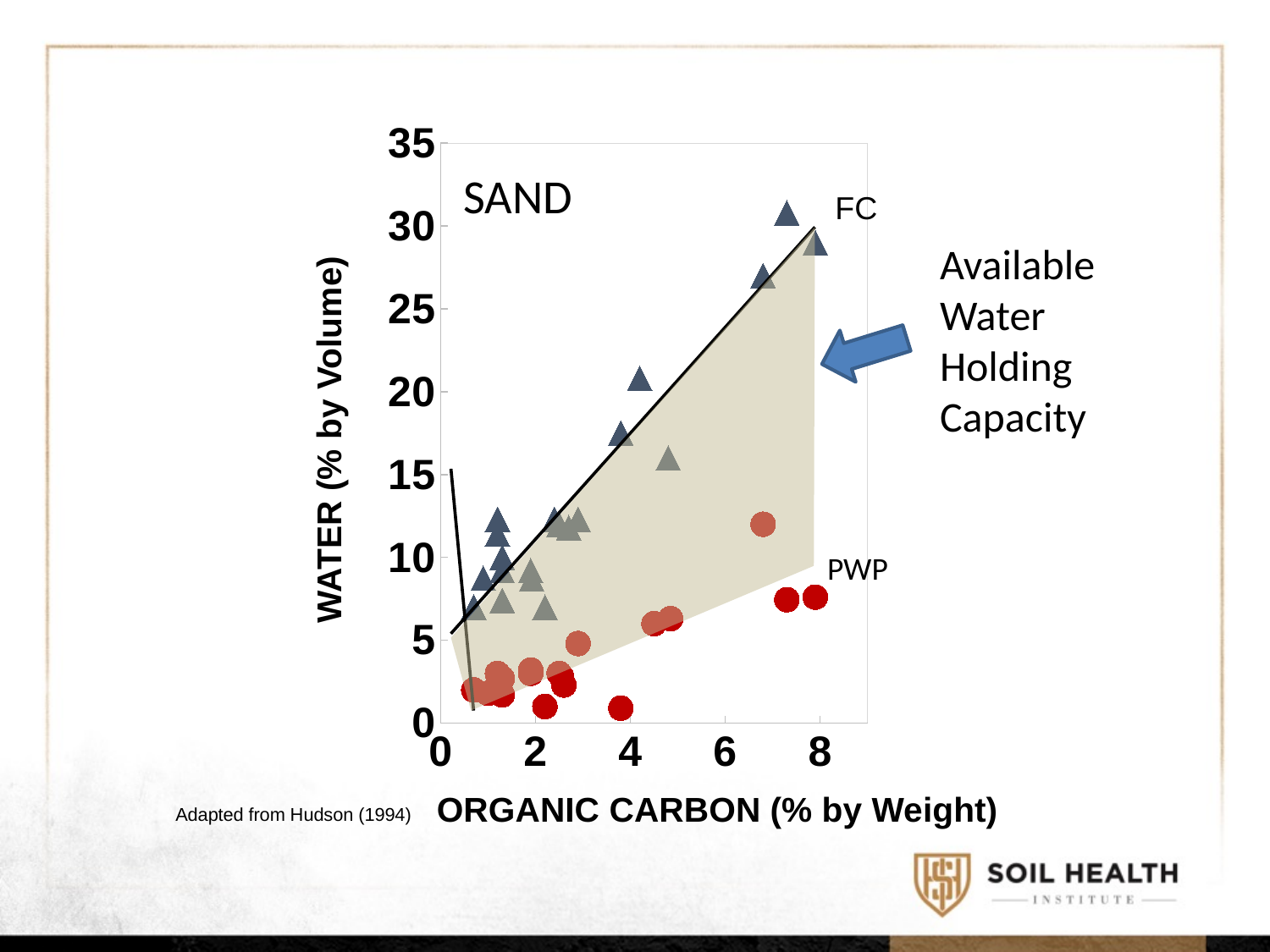
Which series has the higher water values, FC or PWP? FC What is the title of the x axis of the chart? ORGANIC CARBON (% by Weight) What is the title of the y axis of the chart? WATER (% by Volume) Is the lowest FC (triangle) value greater or less than 10? less Is the highest PWP (circle) value greater or less than 15? less What is the maximum tick value shown on the x axis of the chart? 8 How many data series are plotted on the chart? 2 Do the FC (triangle) values rise or fall as organic carbon increases along the x axis? rise Do the PWP (circle) values generally rise or fall as organic carbon increases along the x axis? rise What kind of chart is shown on the slide? scatter chart Is the highest FC (triangle) value greater or less than 25? greater